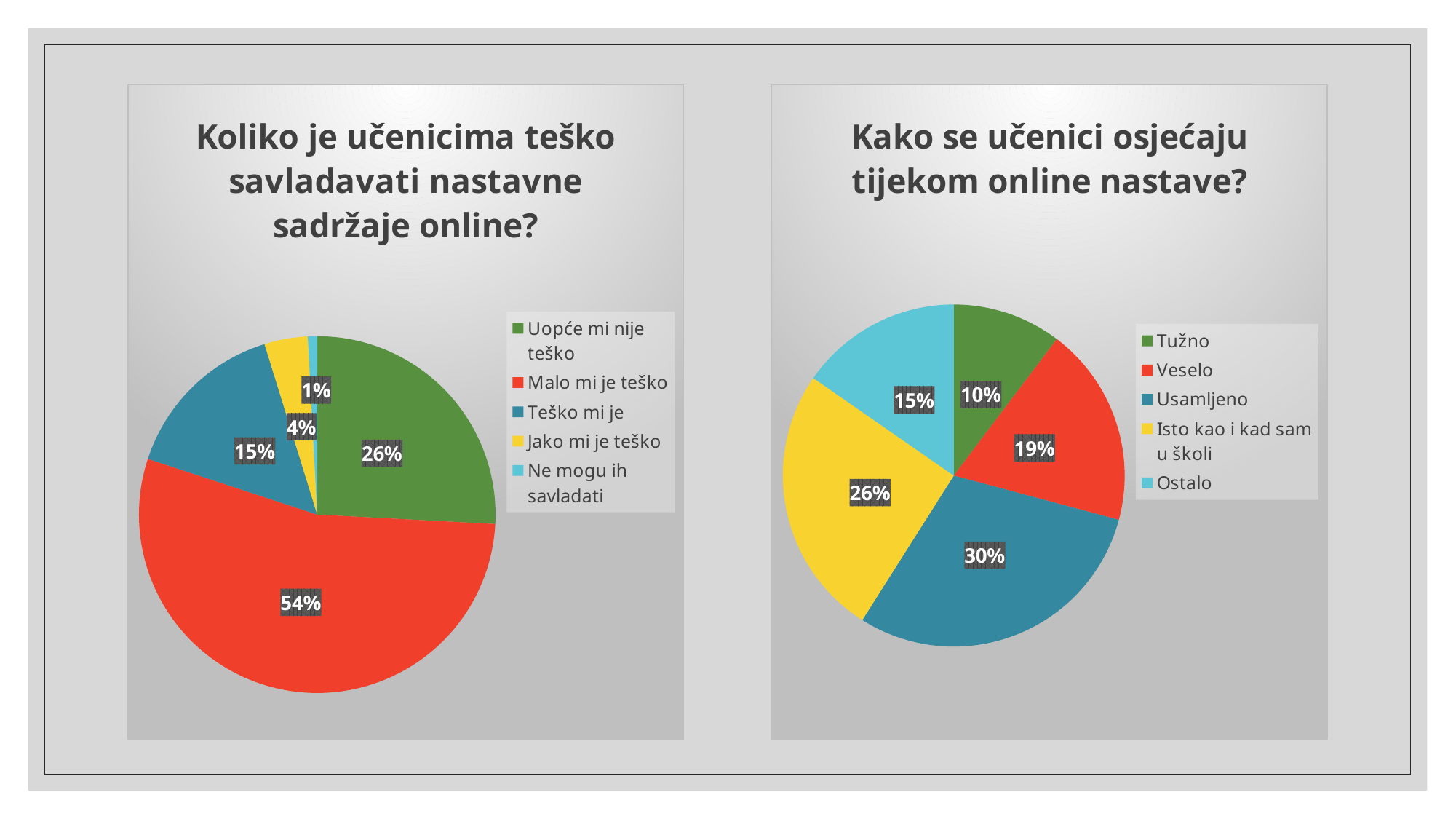
In the left chart 'Koliko je učenicima teško savladavati nastavne sadržaje online?', which category has the smallest slice? Ne mogu ih savladati In the right chart 'Kako se učenici osjećaju tijekom online nastave?', what share is labelled for 'Veselo'? 19% In the left chart 'Koliko je učenicima teško savladavati nastavne sadržaje online?', what share is labelled for 'Malo mi je teško'? 54% In the left chart 'Koliko je učenicima teško savladavati nastavne sadržaje online?', what is the difference between the shares for 'Teško mi je' and 'Jako mi je teško'? 11% In the right chart 'Kako se učenici osjećaju tijekom online nastave?', what share is labelled for 'Usamljeno'? 30% In the left chart 'Koliko je učenicima teško savladavati nastavne sadržaje online?', what share is labelled for 'Uopće mi nije teško'? 26% In the right chart 'Kako se učenici osjećaju tijekom online nastave?', which is larger: 'Isto kao i kad sam u školi' or 'Ostalo'? Isto kao i kad sam u školi In the left chart 'Koliko je učenicima teško savladavati nastavne sadržaje online?', which category has the largest slice? Malo mi je teško What type of chart is the right chart 'Kako se učenici osjećaju tijekom online nastave?'? Pie chart How many categories does the legend of the left chart 'Koliko je učenicima teško savladavati nastavne sadržaje online?' list? 5 In the right chart 'Kako se učenici osjećaju tijekom online nastave?', what colour is the 'Ostalo' slice? Light blue In the right chart 'Kako se učenici osjećaju tijekom online nastave?', which category has the smallest slice? Tužno